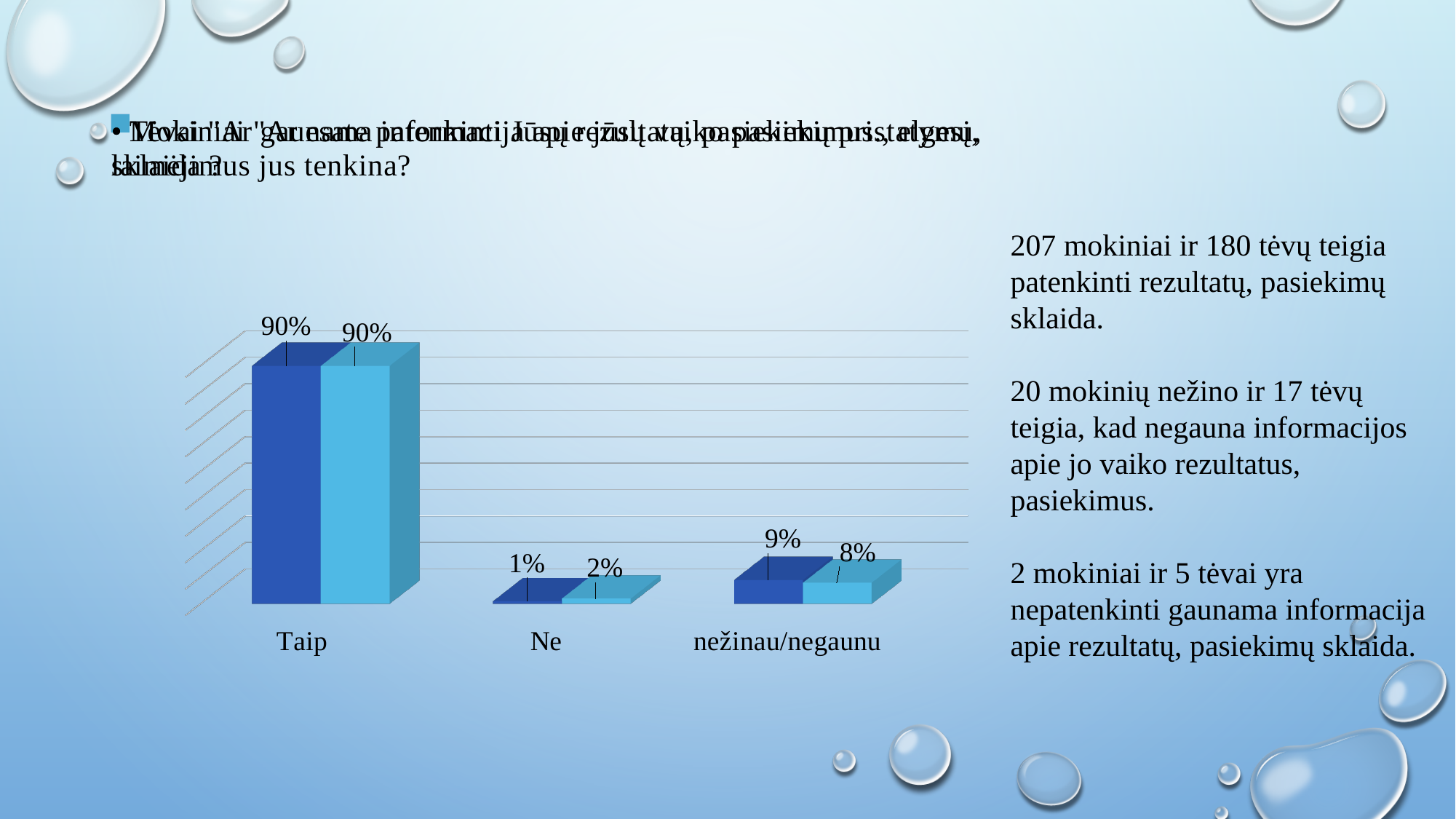
How many categories are shown on the x axis of the chart? 3 Which is larger: the dark blue bar for "nežinau/negaunu" or the light blue bar for "nežinau/negaunu"? the dark blue bar (9%) What kind of chart is shown on the slide? bar chart What is the value of the light blue bar for "Taip"? 90% What is the value of the light blue bar for "nežinau/negaunu"? 8% What is the value of the light blue bar for "Ne"? 2% What is the difference between the dark blue bar for "Taip" and the dark blue bar for "nežinau/negaunu"? 81% Which category has the highest values in the chart? Taip Which category has the lowest value for the dark blue bars? Ne What is the value of the dark blue bar for "Ne"? 1% What is the value of the dark blue bar for "Taip"? 90% What is the value of the dark blue bar for "nežinau/negaunu"? 9%